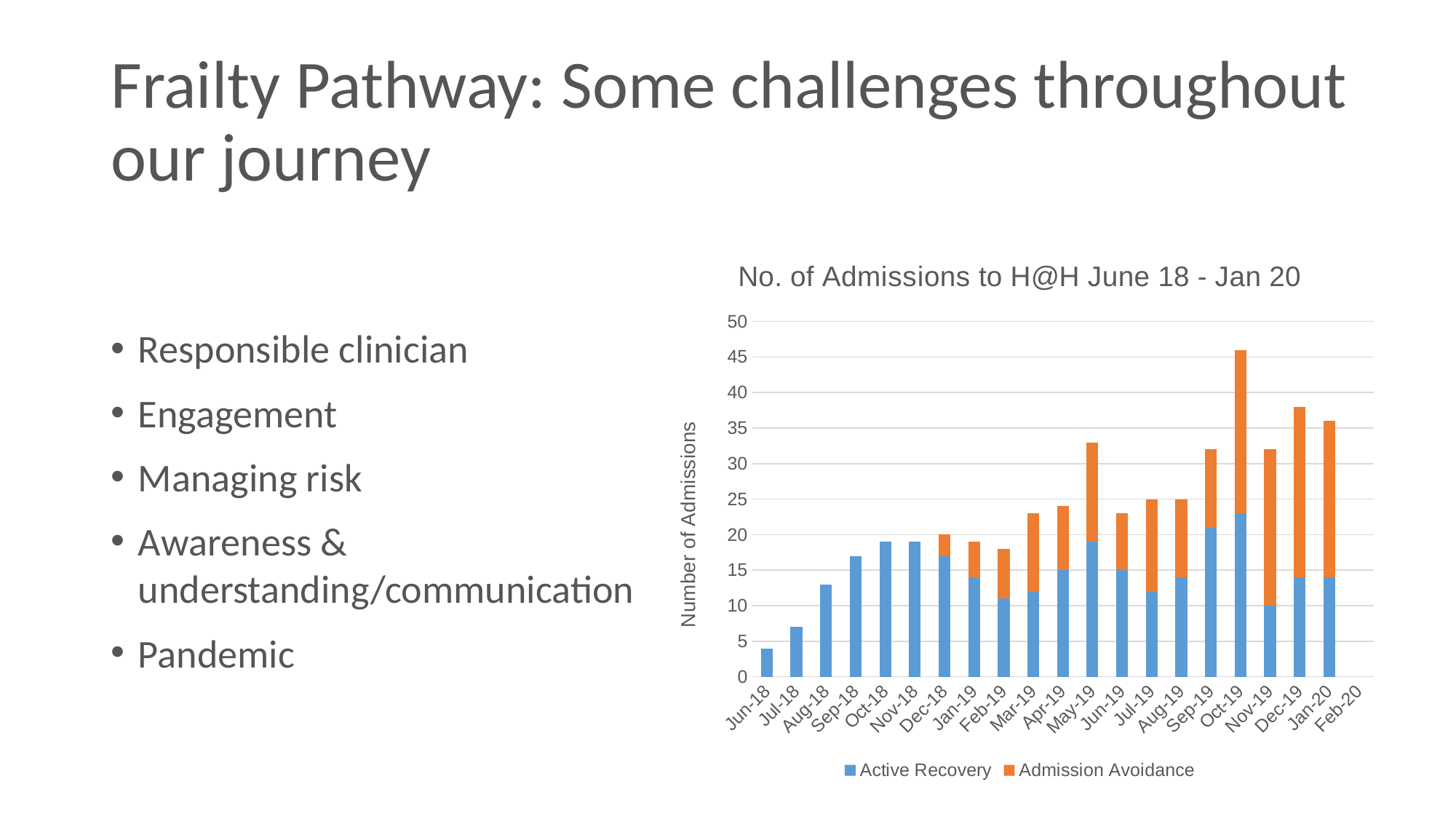
How many series does the legend list? 2 Which series is shown in orange? Admission Avoidance Do the total admissions generally rise or fall from Jun-18 to Jan-20? Rise Is the total value for Feb-19 greater or less than 20? less Is the total value for Oct-19 greater or less than 40? greater Which month has the lowest total number of admissions? Jun-18 Is the total value for Aug-18 greater or less than 10? greater What is the title of the chart? No. of Admissions to H@H June 18 - Jan 20 Which month has the highest total number of admissions? Oct-19 What kind of chart is shown on the slide? Bar chart Which has a larger total number of admissions, Oct-19 or Dec-19? Oct-19